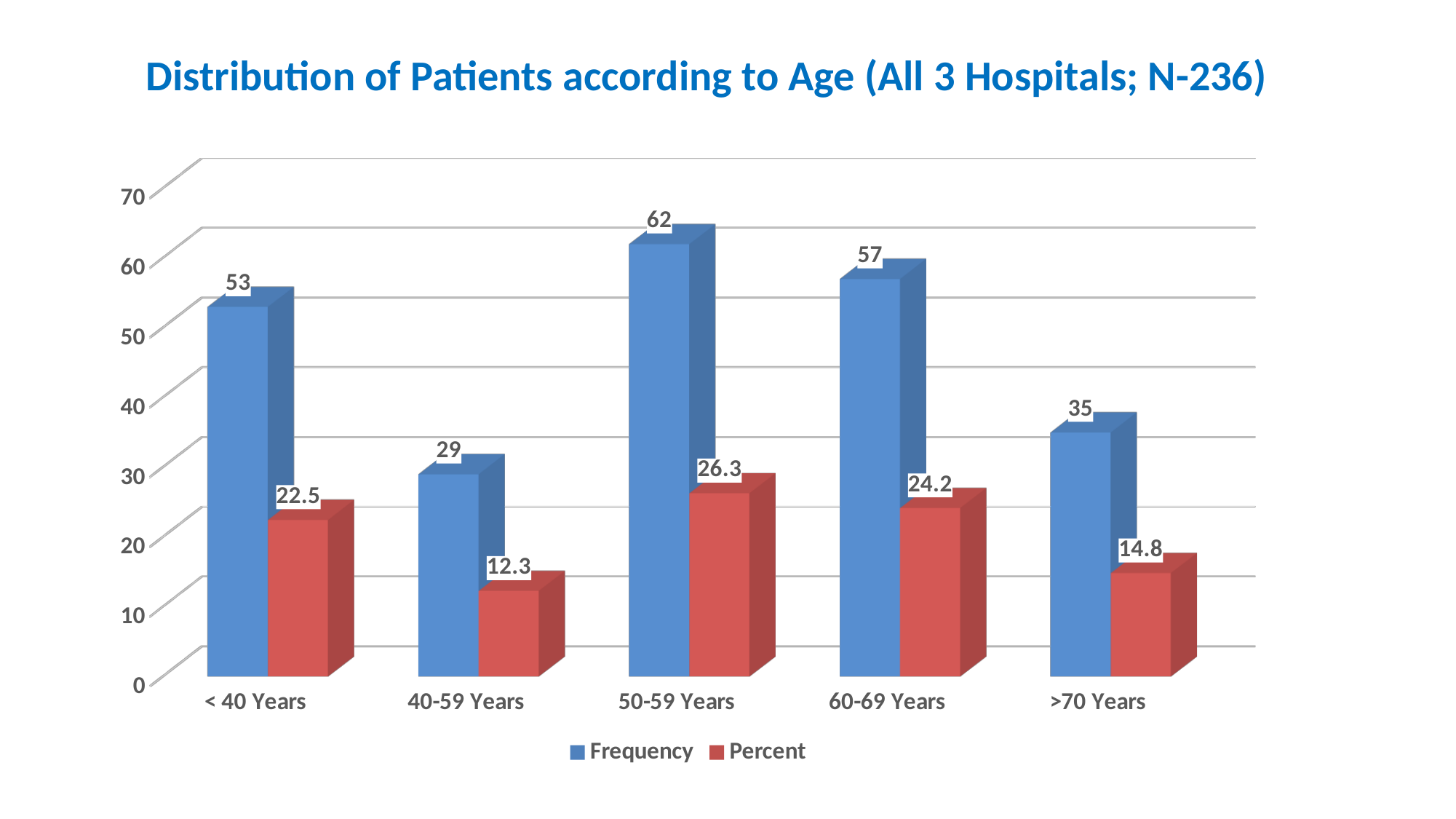
How many series does the legend list? 2 Which age category has the highest Frequency? 50-59 Years What is the Percent value for the >70 Years category? 14.8 How many age categories are shown on the x axis? 5 What is the title of the chart? Distribution of Patients according to Age (All 3 Hospitals; N-236) Which is larger, the Frequency for < 40 Years or the Frequency for >70 Years? < 40 Years What is the Frequency value for the 40-59 Years category? 29 What is the difference between the Percent values for < 40 Years and >70 Years? 7.7 Which age category has the lowest Percent value? 40-59 Years What is the difference between the Frequency values for 50-59 Years and 60-69 Years? 5 What is the Frequency value for the 50-59 Years category? 62 What kind of chart is shown on the slide? Bar chart